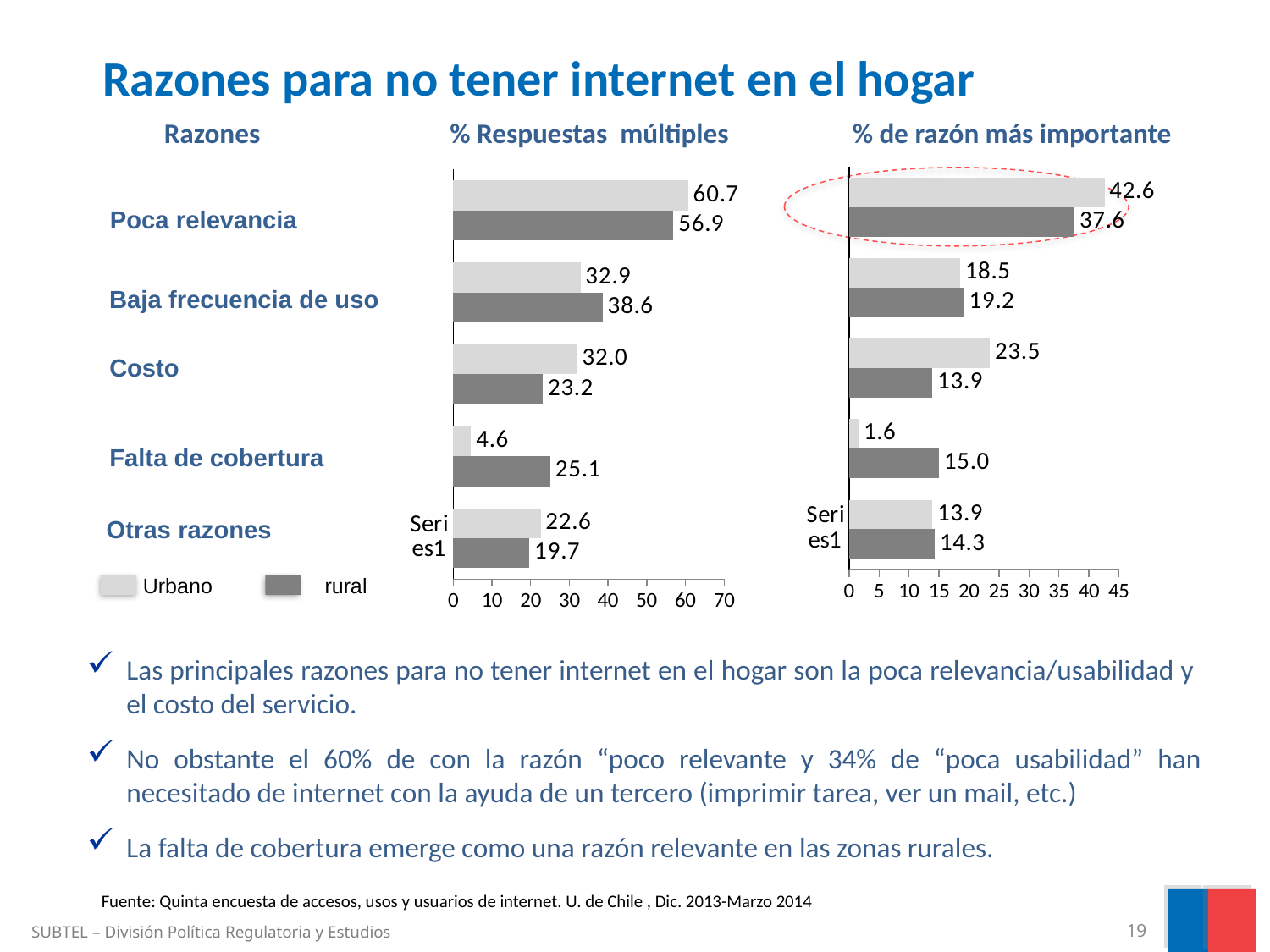
In the "% Respuestas múltiples" chart, what is the Urbano value for Poca relevancia? 60.7 In the "% de razón más importante" chart, which is larger for Baja frecuencia de uso, the Urbano value or the rural value? rural In the "% Respuestas múltiples" chart, what is the difference between the rural and Urbano values for Falta de cobertura? 20.5 In the "% Respuestas múltiples" chart, what is the rural value for Falta de cobertura? 25.1 What kind of chart is the "% Respuestas múltiples" chart? bar chart In the "% Respuestas múltiples" chart, is the Urbano value for Costo greater or less than 30? greater In the "% Respuestas múltiples" chart, which category has the highest rural value? Poca relevancia In the "% de razón más importante" chart, which category has the lowest Urbano value? Falta de cobertura In the "% de razón más importante" chart, what is the rural value for Otras razones? 14.3 In the "% de razón más importante" chart, what is the Urbano value for Costo? 23.5 How many categories (razones) are shown in the "% de razón más importante" chart? 5 How many series does the legend list for the charts on this slide? 2